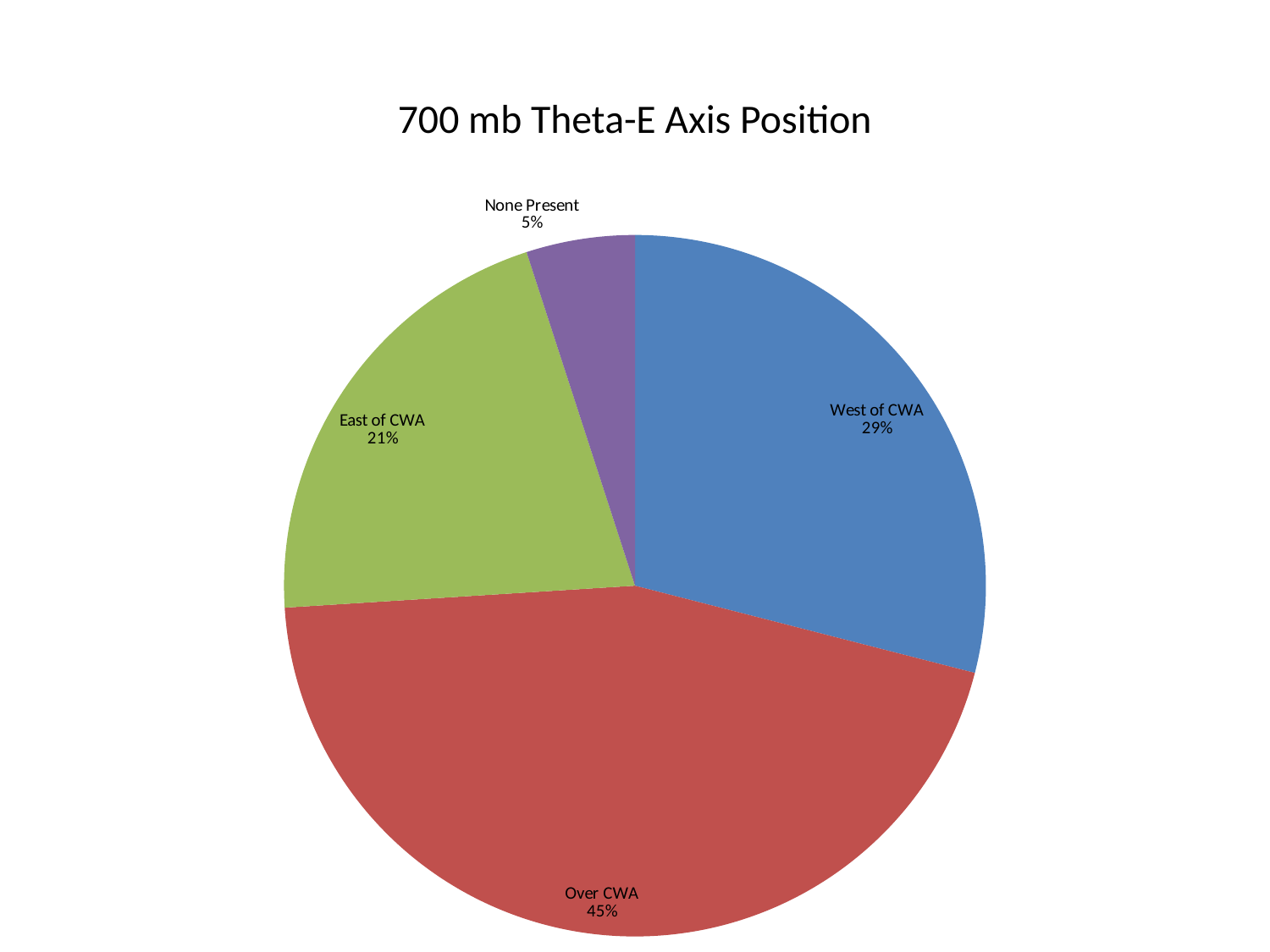
How many slices does the pie chart have? 4 What share of the pie is labelled None Present? 5% What share of the pie is labelled West of CWA? 29% Which category has the smallest slice of the pie? None Present Which is larger, the share for West of CWA or the share for East of CWA? West of CWA What colour is the Over CWA slice? red What share of the pie is labelled Over CWA? 45% What is the title of the chart? 700 mb Theta-E Axis Position Which category has the largest slice of the pie? Over CWA What is the difference in percentage points between Over CWA and West of CWA? 16 What kind of chart is shown on the slide? pie chart